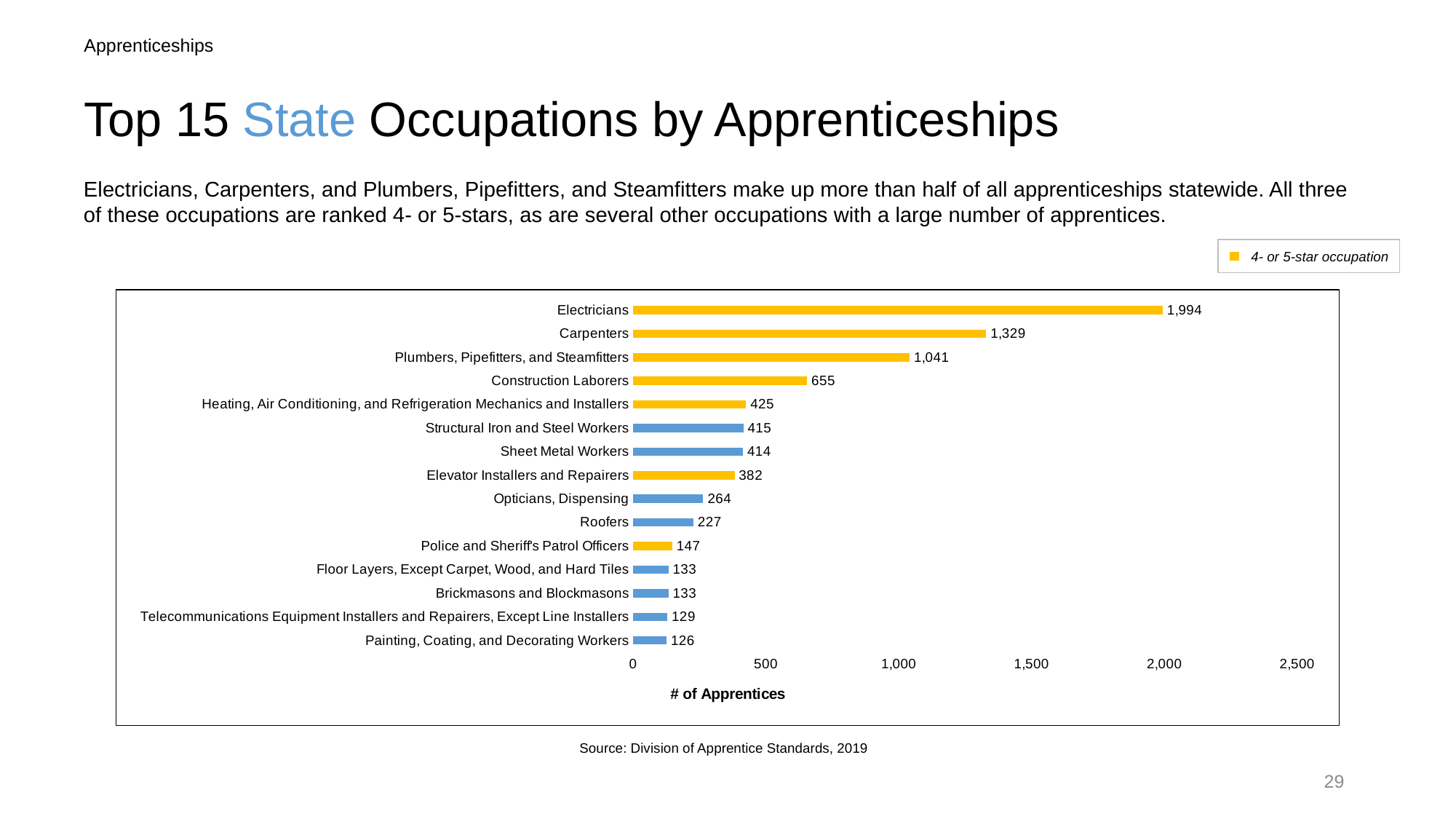
Which has more apprentices, Elevator Installers and Repairers or Opticians, Dispensing? Elevator Installers and Repairers What is the difference in apprentices between Electricians and Carpenters? 665 What does the yellow colour in the chart indicate, according to the legend? 4- or 5-star occupation How many apprentices are shown for Construction Laborers? 655 How many apprentices are shown for Electricians? 1,994 What kind of chart is shown on the slide? Bar chart How many apprentices are shown for Roofers? 227 Which occupation has the highest number of apprentices? Electricians What is the difference in apprentices between Plumbers, Pipefitters, and Steamfitters and Construction Laborers? 386 Is the value for Carpenters greater or less than 1,000? greater Which occupation has the lowest number of apprentices? Painting, Coating, and Decorating Workers How many occupations are shown in the chart? 15